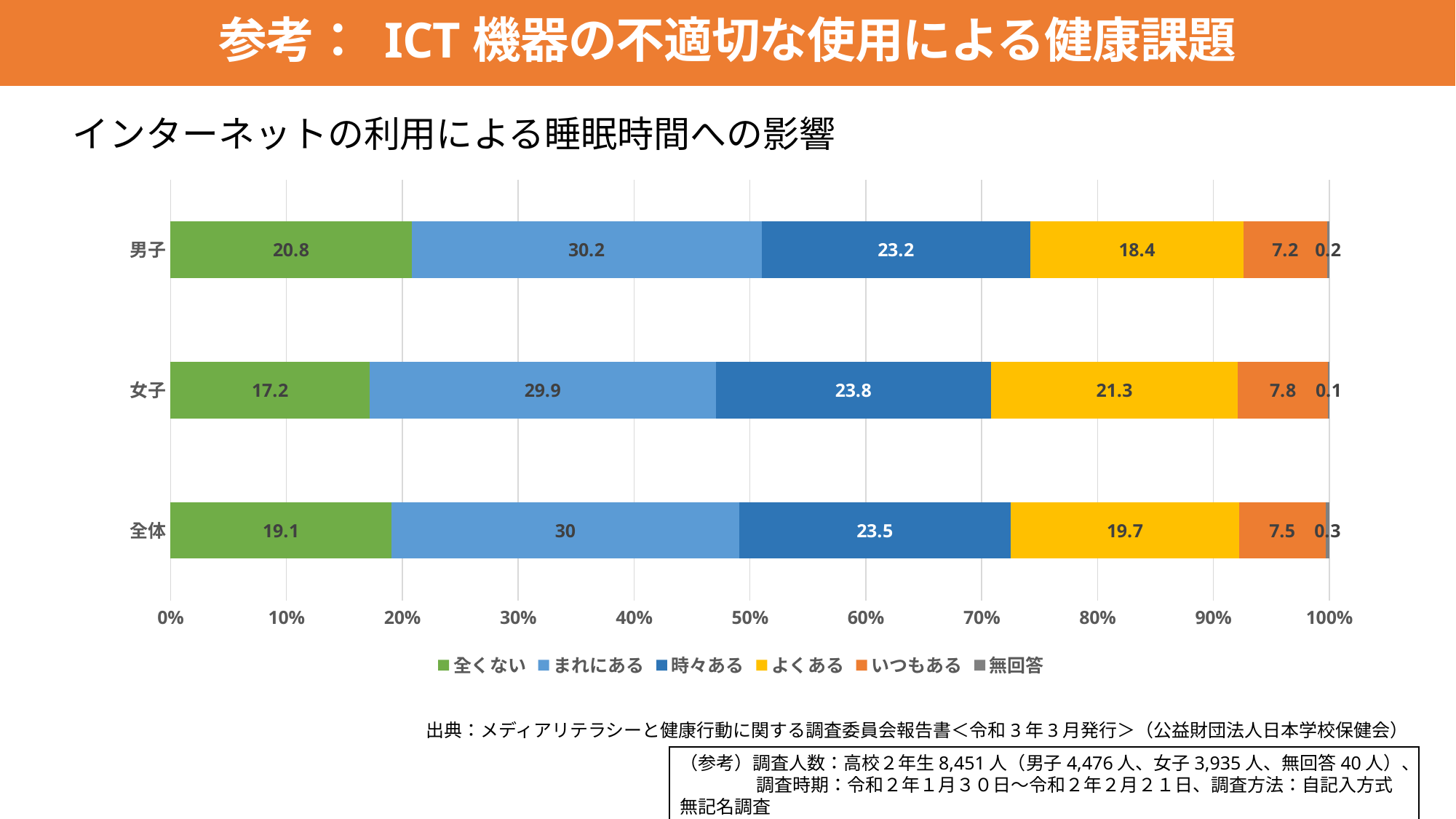
How many series does the legend list? 6 Which category has the highest value for 全くない? 男子 What is the first entry in the chart's legend? 全くない What is the value of まれにある for 全体? 30 What is the difference between the よくある values for 女子 and 男子? 2.9 What is the value of よくある for 女子? 21.3 Which category has the lowest value for いつもある? 男子 How many categories are shown on the vertical axis of the chart? 3 Which is larger, the 時々ある value for 男子 or for 女子? 女子 What kind of chart is shown on the slide? Stacked bar chart What is the value of 全くない for 男子? 20.8 What is the value of 無回答 for 全体? 0.3